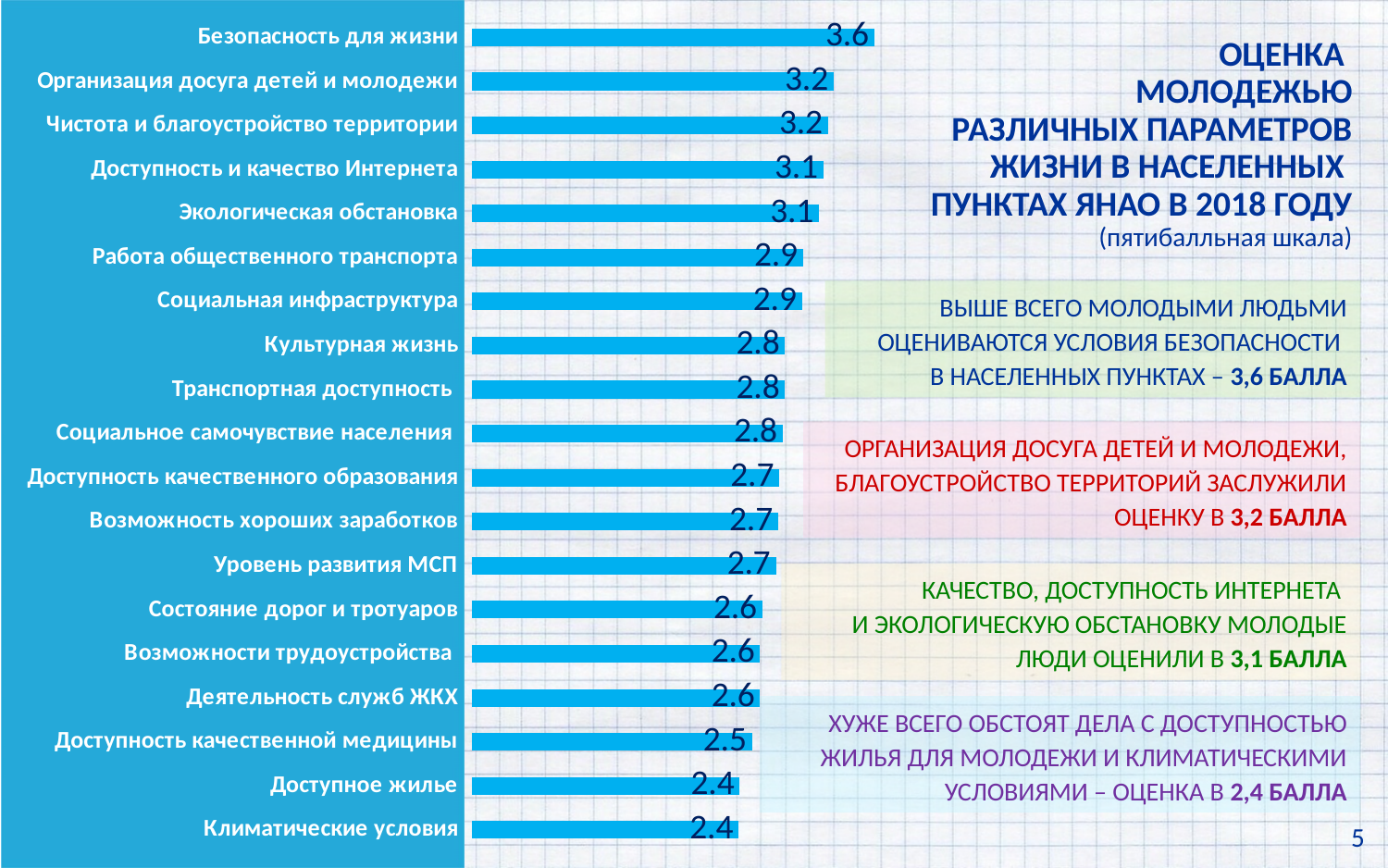
What is the value for Работа общественного транспорта? 2.9 What is the difference between the values for Организация досуга детей и молодежи and Состояние дорог и тротуаров? 0.6 Which category has the highest value? Безопасность для жизни How many categories are shown on the chart? 19 What is the difference between the values for Безопасность для жизни and Климатические условия? 1.2 What kind of chart is shown on the slide? Bar chart What is the value for Доступность качественной медицины? 2.5 Which is larger: the value for Экологическая обстановка or the value for Культурная жизнь? Экологическая обстановка What is the value for Безопасность для жизни? 3.6 What is the value for Уровень развития МСП? 2.7 What is the lowest value shown on the chart? 2.4 What colour are the bars on the chart? Blue